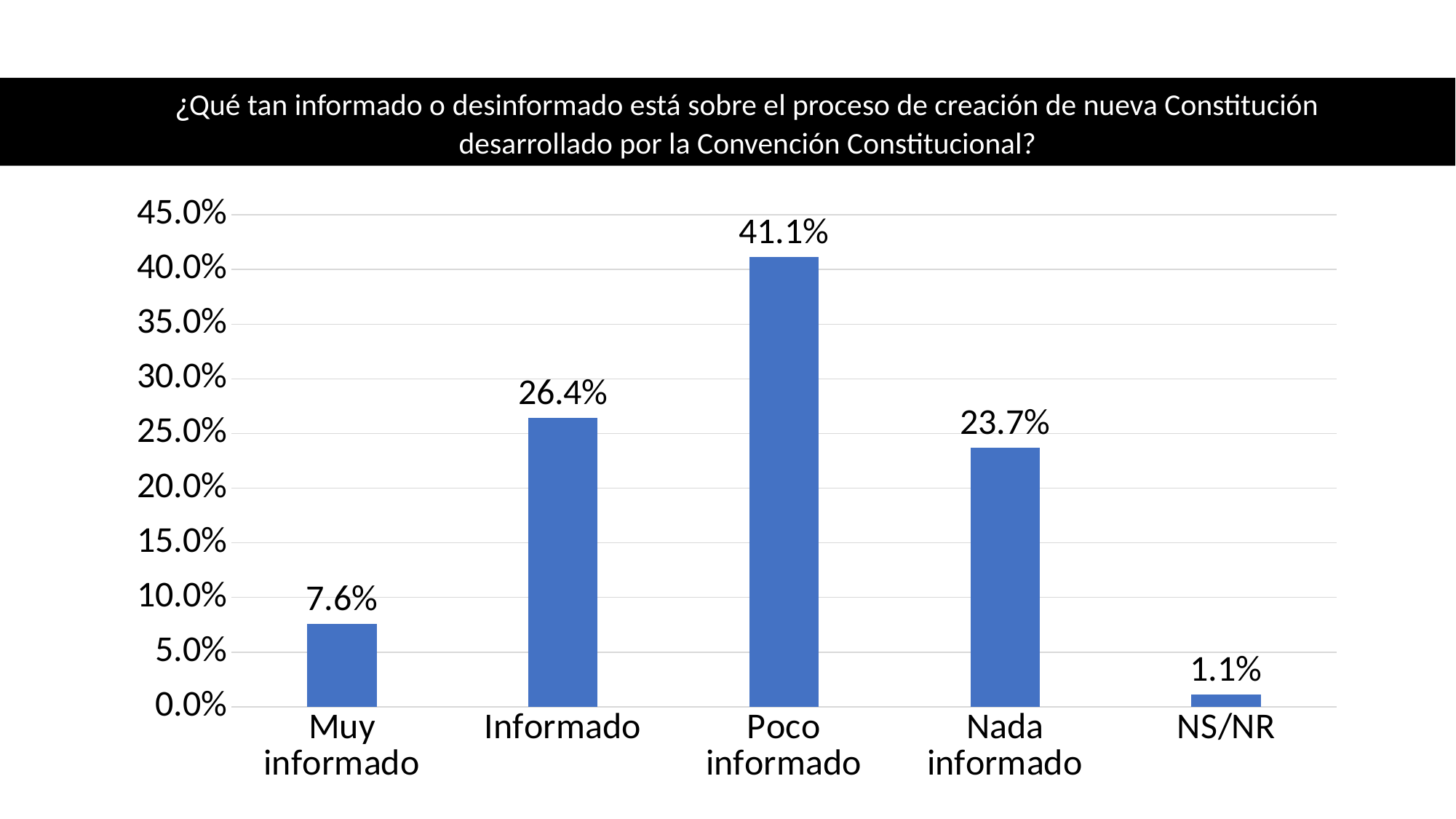
What is the value for "Muy informado"? 7.6% Which category has the lowest value? NS/NR What is the difference between "Informado" and "Nada informado"? 2.7% What is the difference between "Poco informado" and "Muy informado"? 33.5% Which is larger, "Informado" or "Nada informado"? Informado Which category has the highest value? Poco informado What is the value for "Poco informado"? 41.1% What is the value for "NS/NR"? 1.1% How many categories are shown on the x axis? 5 What kind of chart is shown on the slide? Bar chart What is the highest value shown on the y axis? 45.0% Is the value for "Nada informado" greater or less than 20.0%? greater